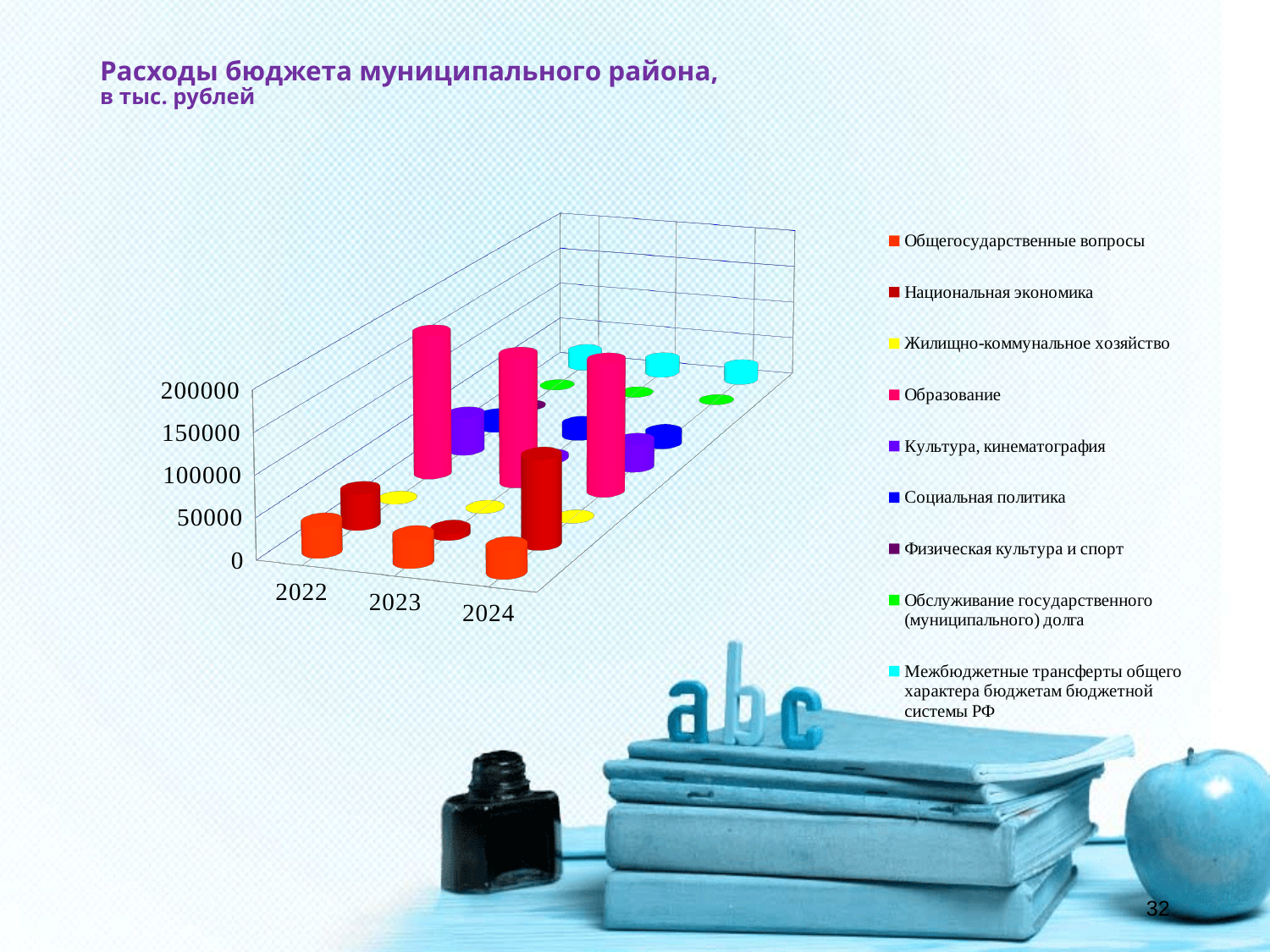
Which expenditure series has the tallest bar in 2024? Образование What is the title of the chart on the slide? Расходы бюджета муниципального района, в тыс. рублей Which is larger in 2023: Образование or Общегосударственные вопросы? Образование Which series is shown in pink in the chart legend? Образование Does the value for Национальная экономика rise or fall from 2023 to 2024? rise Which is larger: Национальная экономика in 2024 or Национальная экономика in 2022? 2024 Is the value for Образование in 2022 greater or less than 100000? greater How many years are shown along the x axis of the chart? 3 What kind of chart is shown on the slide? bar chart Is the value for Общегосударственные вопросы in 2022 greater or less than 100000? less How many series does the chart legend list? 9 Which expenditure series has the tallest bar in 2022? Образование